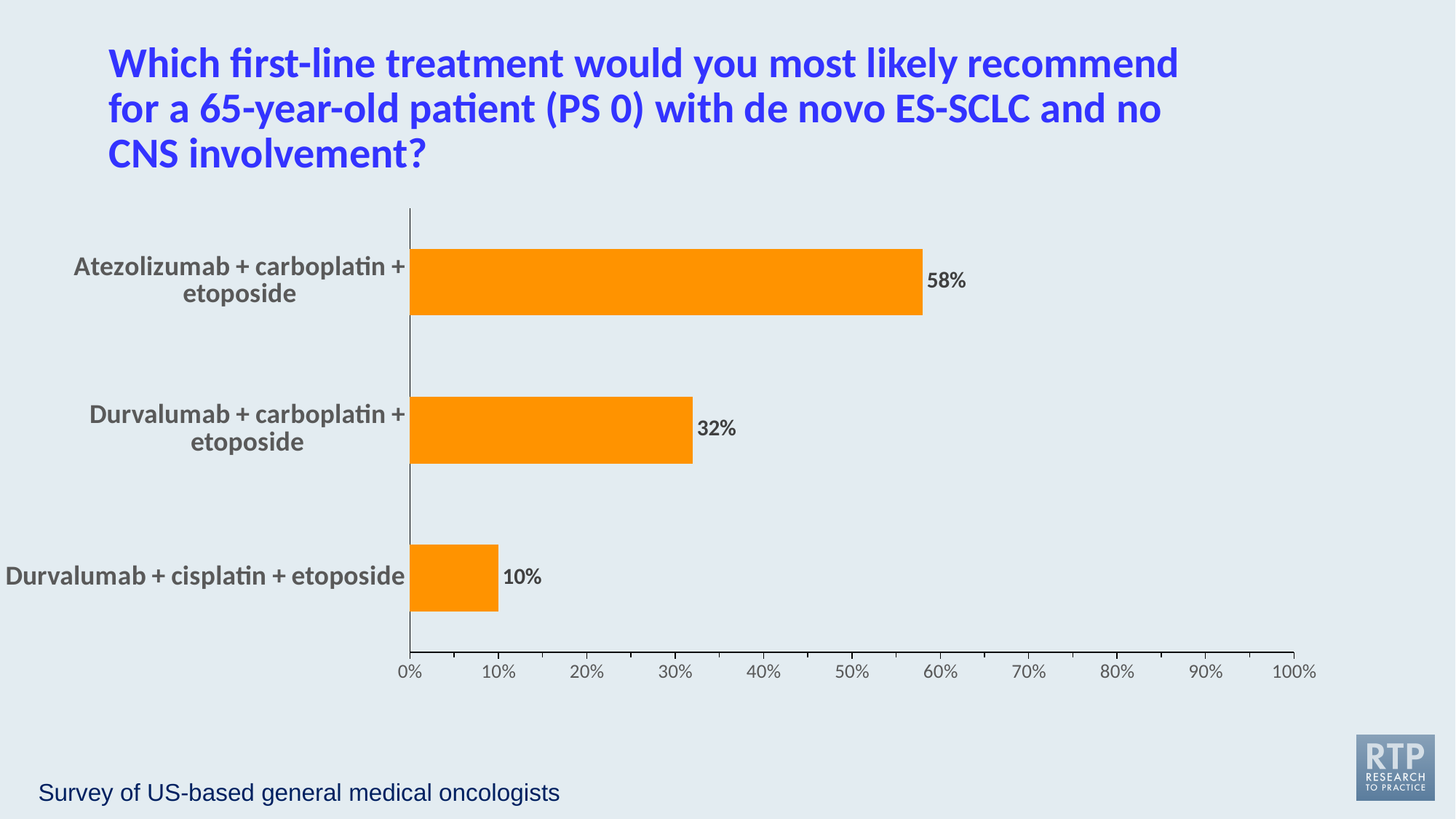
What type of chart is shown on the slide? Bar chart Which treatment option received the highest percentage of responses? Atezolizumab + carboplatin + etoposide How many treatment options are shown in the chart? 3 What is the difference in percentage points between durvalumab + carboplatin + etoposide and durvalumab + cisplatin + etoposide? 22 percentage points Which treatment option received the lowest percentage of responses? Durvalumab + cisplatin + etoposide What is the maximum value shown on the horizontal axis? 100% What is the difference in percentage points between atezolizumab + carboplatin + etoposide and durvalumab + carboplatin + etoposide? 26 percentage points Which received a larger share of responses: durvalumab + carboplatin + etoposide or durvalumab + cisplatin + etoposide? Durvalumab + carboplatin + etoposide Is the value for atezolizumab + carboplatin + etoposide greater or less than 50%? greater What percentage of respondents chose durvalumab + carboplatin + etoposide? 32% What percentage of respondents chose atezolizumab + carboplatin + etoposide? 58% What percentage of respondents chose durvalumab + cisplatin + etoposide? 10%